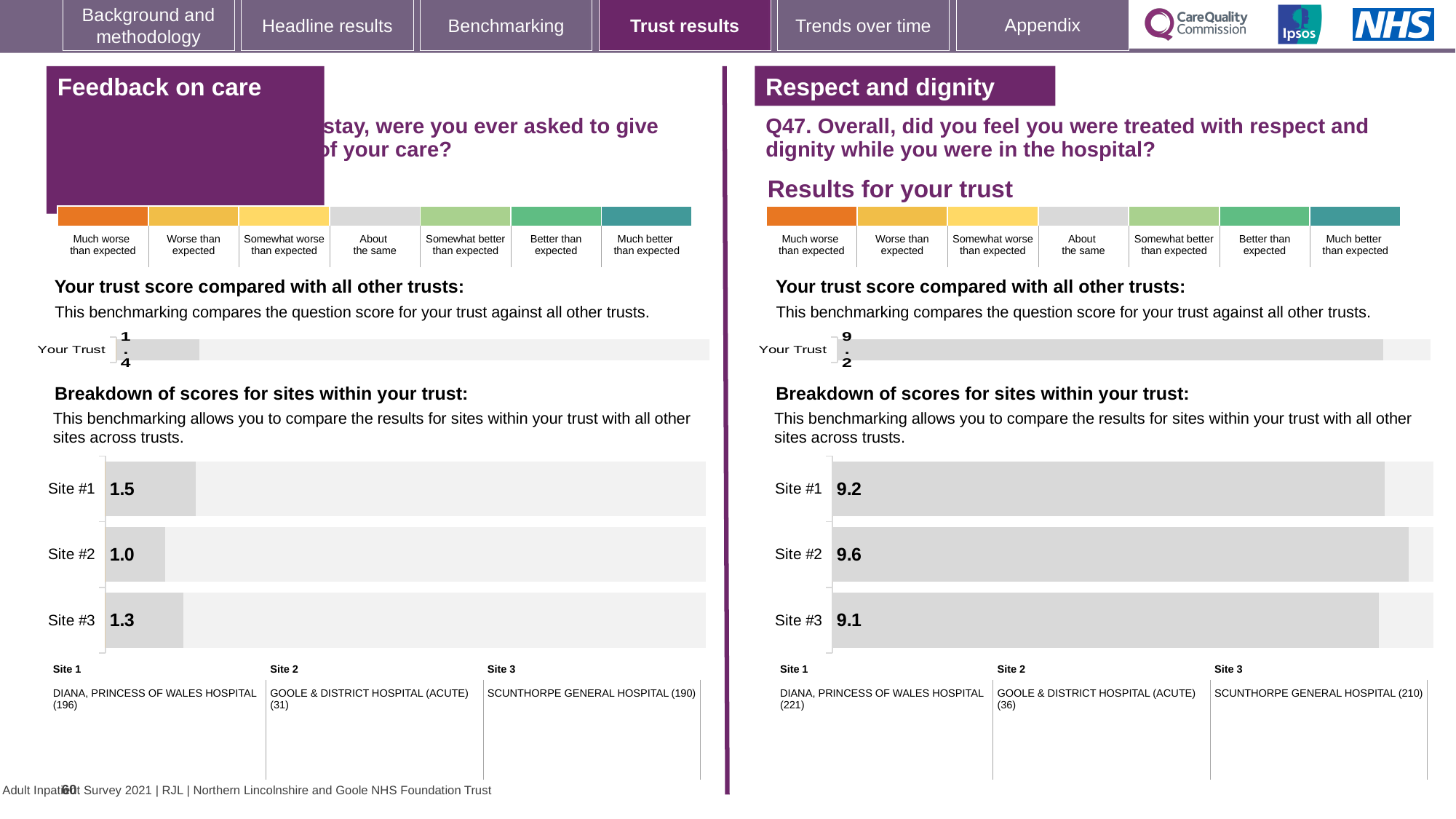
How many sites are shown in the 'Respect and dignity' site breakdown chart? 3 In the 'Feedback on care' site breakdown chart, what is the score for Site #1? 1.5 What kind of chart is used for the site breakdown under 'Feedback on care'? Bar chart In the 'Feedback on care' site breakdown chart, what is the score for Site #2? 1.0 In the 'Respect and dignity' 'Your trust score compared with all other trusts' chart, what is the value for Your Trust? 9.2 In the 'Respect and dignity' site breakdown chart, which site has the highest score? Site #2 In the 'Feedback on care' 'Your trust score compared with all other trusts' chart, what is the value for Your Trust? 1.4 In the 'Respect and dignity' site breakdown chart, what is the score for Site #3? 9.1 In the 'Feedback on care' site breakdown chart, what is the difference between the scores for Site #1 and Site #2? 0.5 In the 'Respect and dignity' site breakdown chart, what is the difference between the scores for Site #2 and Site #3? 0.5 In the 'Feedback on care' site breakdown chart, which has a higher score, Site #1 or Site #3? Site #1 In the 'Feedback on care' site breakdown chart, which site has the lowest score? Site #2